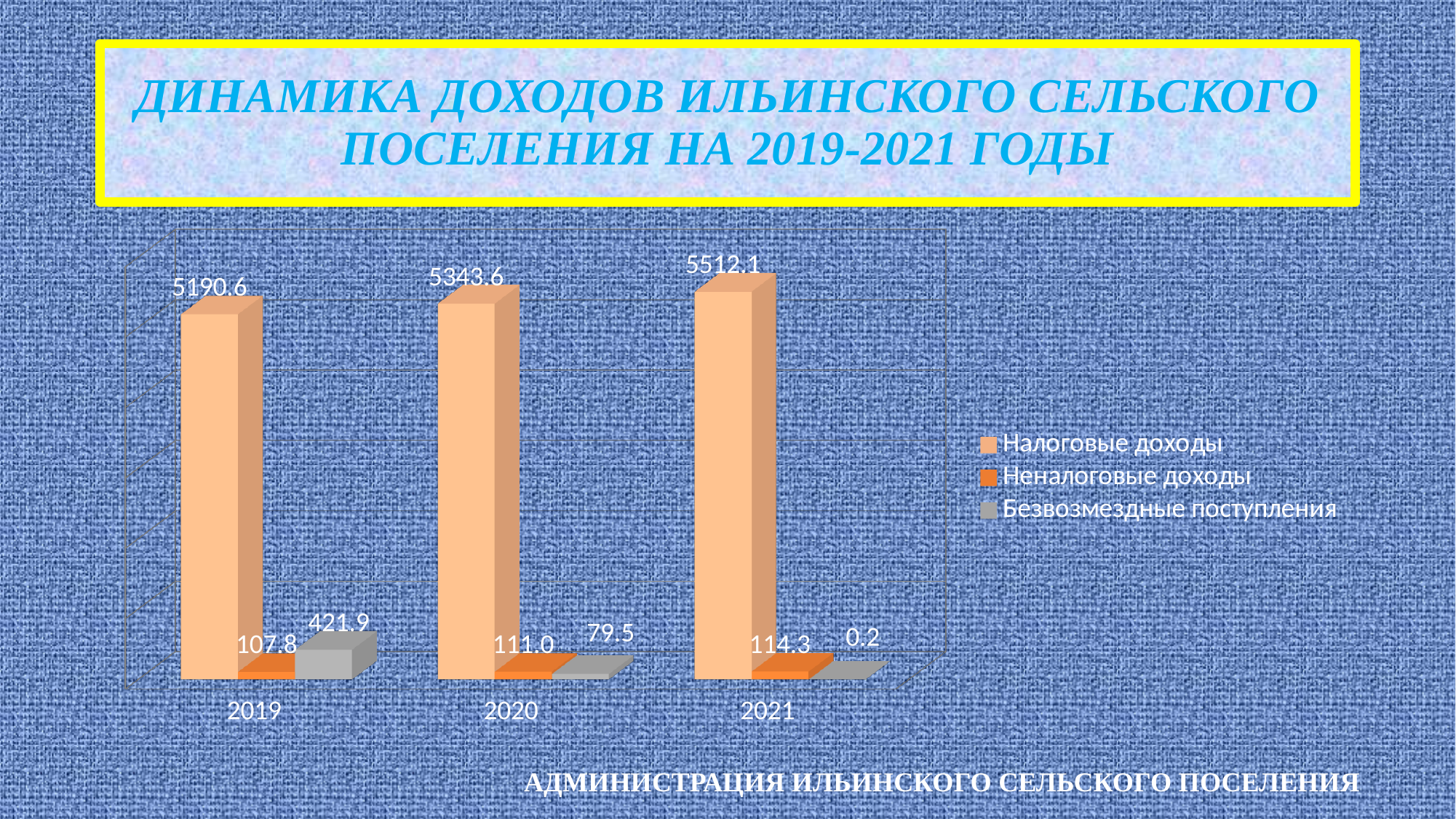
Which is larger in 2020: Неналоговые доходы or Безвозмездные поступления? Неналоговые доходы How many years are shown on the x axis? 3 How many series does the legend list? 3 In which year is Налоговые доходы highest? 2021 In which year is Безвозмездные поступления lowest? 2021 What is the difference between Налоговые доходы in 2021 and in 2019? 321.5 What is the value of Безвозмездные поступления for 2019? 421.9 What is the value of Неналоговые доходы for 2020? 111.0 Do the values of Налоговые доходы rise or fall from 2019 to 2021? Rise What kind of chart is shown on the slide? Bar chart What is the value of Налоговые доходы for 2019? 5190.6 What is the value of Безвозмездные поступления for 2021? 0.2